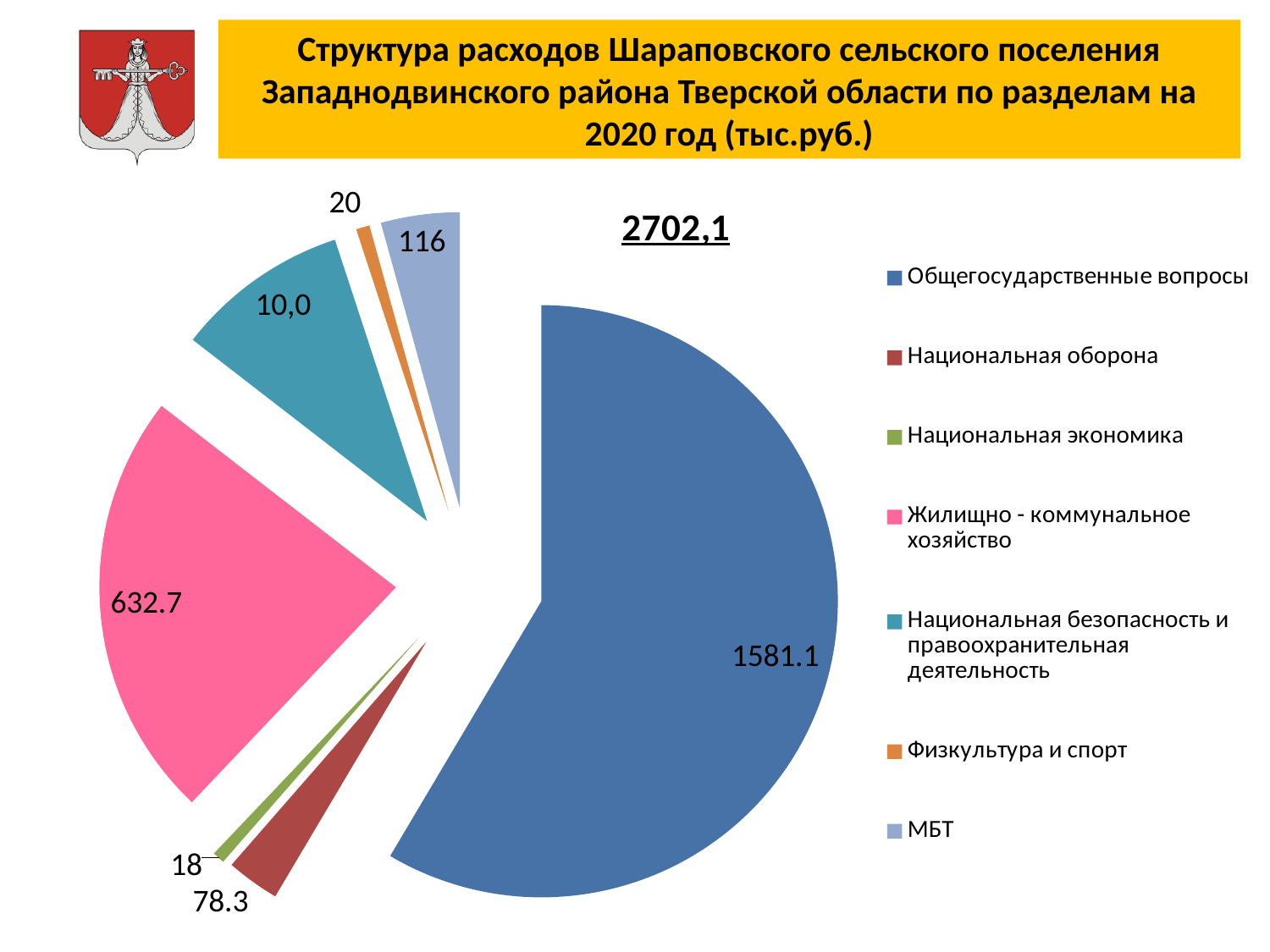
Which is larger: Жилищно - коммунальное хозяйство or МБТ? Жилищно - коммунальное хозяйство What is the value for Общегосударственные вопросы? 1581.1 What total value is printed above the pie chart? 2702,1 What is the value for МБТ? 116 Which category has the largest slice of the pie? Общегосударственные вопросы How many categories does the legend list? 7 What is the difference between the values for Общегосударственные вопросы and Жилищно - коммунальное хозяйство? 948.4 What is the value for Физкультура и спорт? 20 What is the value for Национальная экономика? 18 What is the value for Национальная оборона? 78.3 What type of chart is shown on the slide? pie chart What is the value for Жилищно - коммунальное хозяйство? 632.7